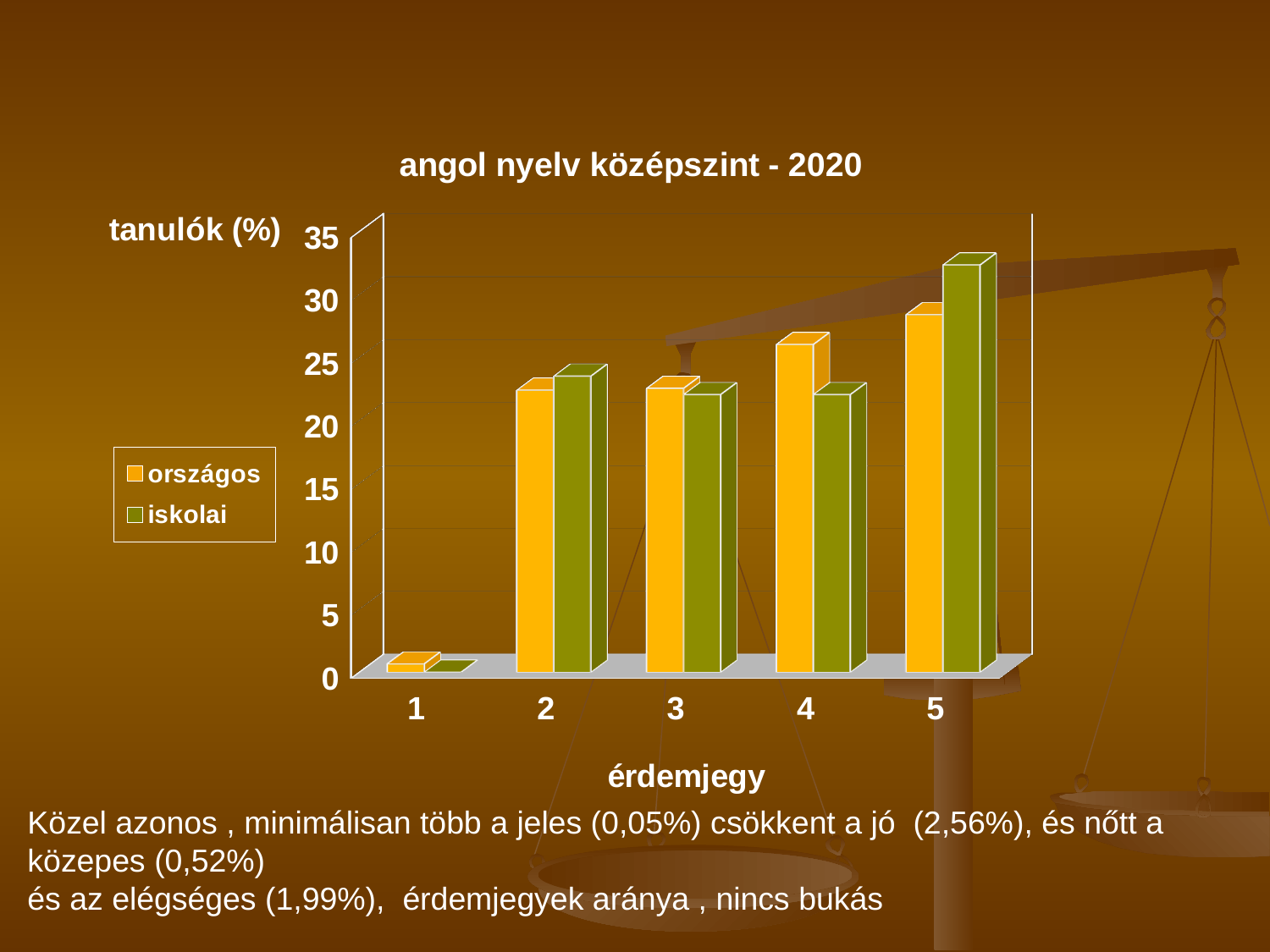
How many grade categories (érdemjegy) are shown on the x axis? 5 For grade 4, which series has the larger value, országos or iskolai? országos For which grade is the iskolai value highest? 5 What kind of chart is shown on the slide? bar chart Is the országos value for grade 1 greater or less than 5? less What is the title of the chart? angol nyelv középszint - 2020 For which grade is the országos value lowest? 1 Is the iskolai value for grade 5 greater or less than 30? greater How many series does the legend list? 2 For which grade is the országos value highest? 5 Is the iskolai value for grade 4 greater or less than 25? less For grade 5, which series has the larger value, országos or iskolai? iskolai